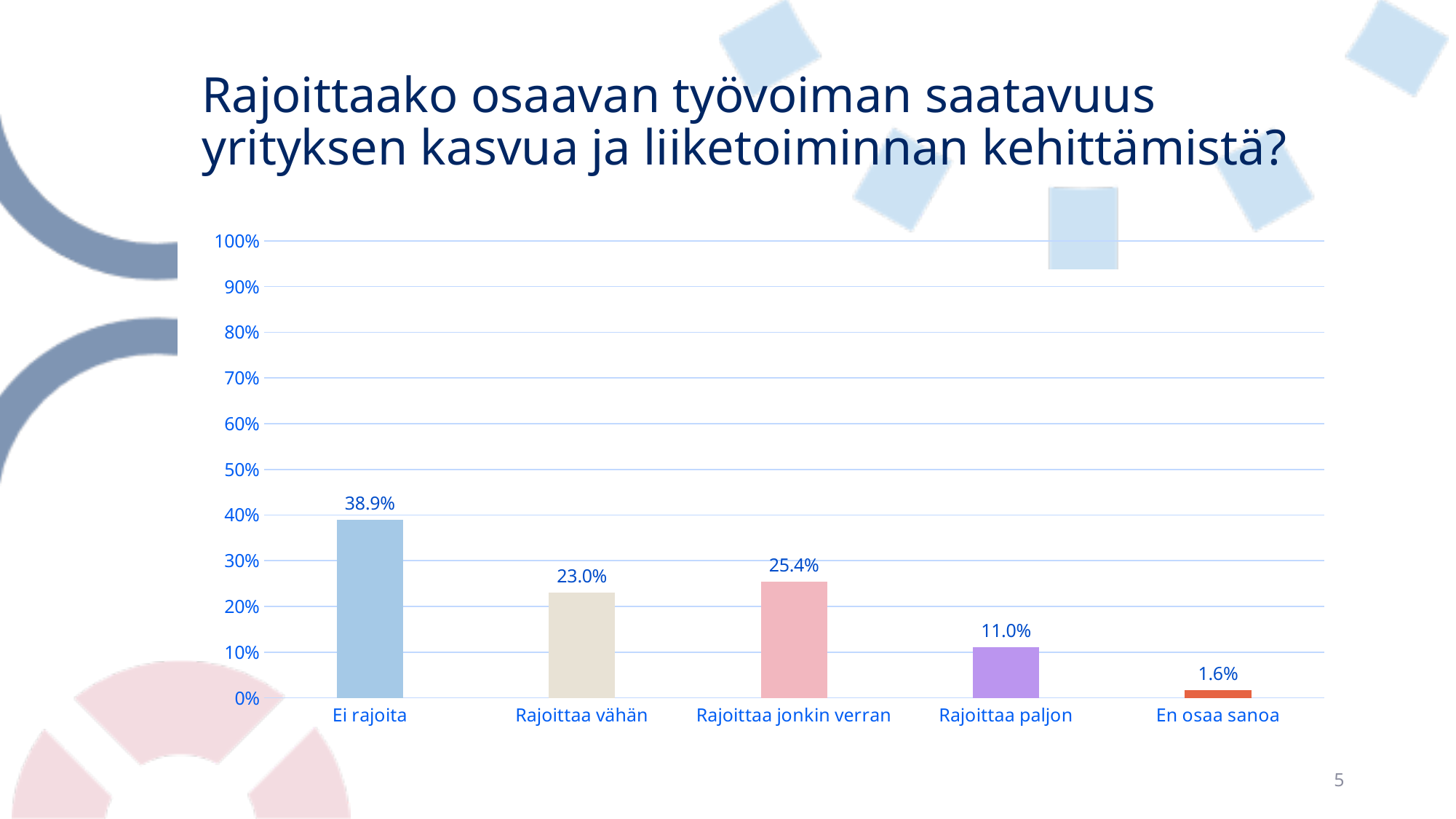
What kind of chart is shown on the slide? bar chart What is the value for "Ei rajoita"? 38.9% Which category has the highest value? Ei rajoita How many categories are shown on the x axis? 5 What is the value for "En osaa sanoa"? 1.6% What is the value for "Rajoittaa jonkin verran"? 25.4% What is the difference between the values for "Ei rajoita" and "Rajoittaa vähän"? 15.9% What is the highest value shown on the y axis? 100% Which category has the lowest value? En osaa sanoa Which is larger, the value for "Rajoittaa vähän" or "Rajoittaa jonkin verran"? Rajoittaa jonkin verran Is the value for "Rajoittaa paljon" greater or less than 20%? less What is the value for "Rajoittaa paljon"? 11.0%